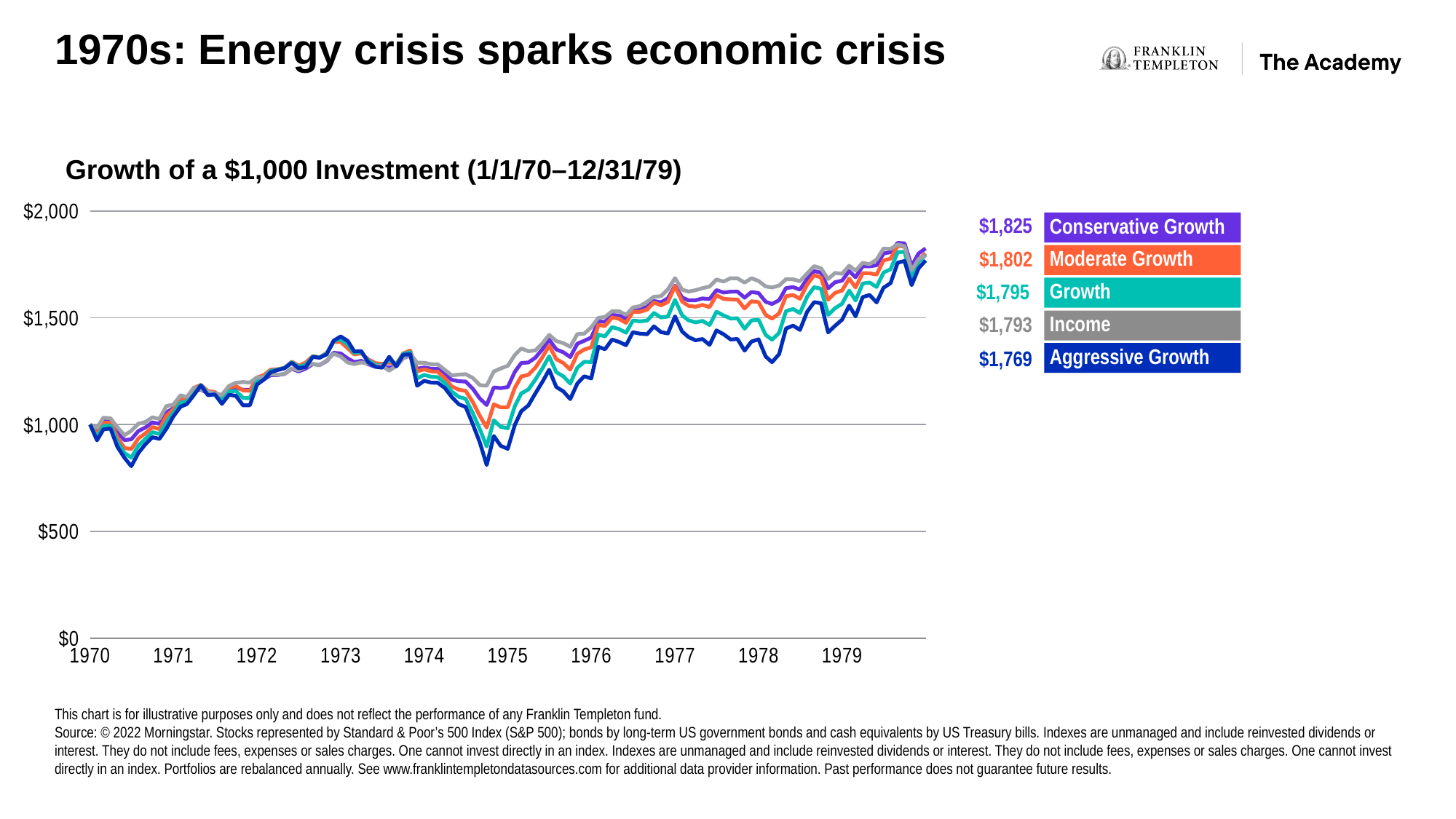
What is the ending value shown for the Aggressive Growth portfolio? $1,769 What is the ending value shown for the Conservative Growth portfolio? $1,825 How many portfolios (series) does the legend list? 5 What is the title of the chart? Growth of a $1,000 Investment (1/1/70–12/31/79) What kind of chart is shown on the slide? Line chart What is the ending value shown for the Income portfolio? $1,793 Is the lowest point of the Aggressive Growth line, around late 1974, greater or less than $1,000? less Which portfolio has the lowest ending value in the legend? Aggressive Growth What is the difference between the ending values of Conservative Growth and Aggressive Growth? $56 Overall, do the portfolio values rise or fall from 1970 to the end of 1979? rise Which has the larger ending value, Moderate Growth or Growth? Moderate Growth Which portfolio has the highest ending value in the legend? Conservative Growth